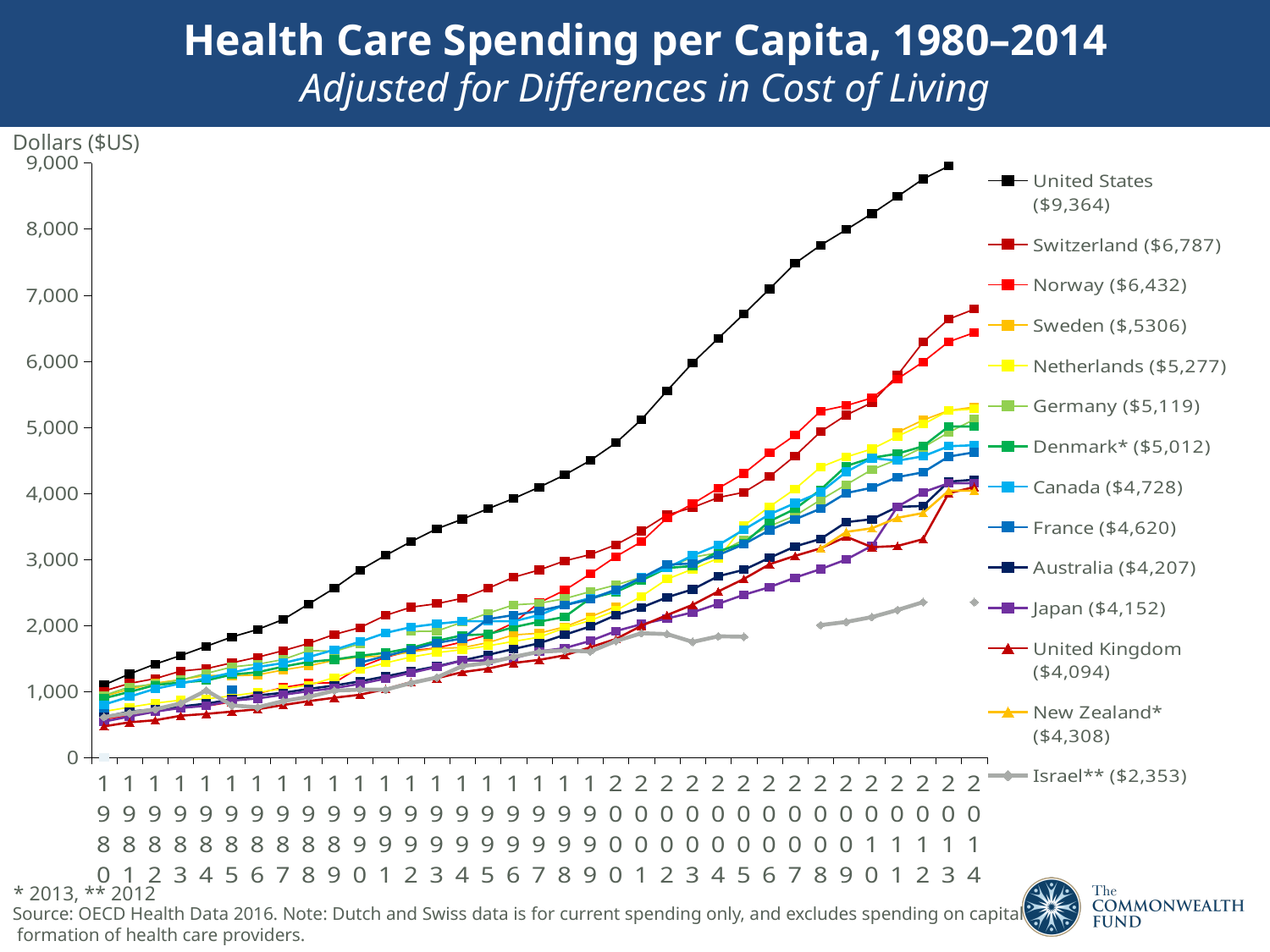
Is the value for Switzerland in 1980 greater or less than 2,000? less Which has the larger legend value, Norway or Switzerland? Switzerland Does the United States line rise or fall from 1980 to 2014? rise What is the label on the vertical axis? Dollars ($US) What value does the legend give for Canada? $4,728 Which country has the lowest health care spending per capita in the chart? Israel How many countries does the legend list? 14 What is the 2014 health care spending per capita for the United States shown in the legend? $9,364 Which country has the highest health care spending per capita in the chart? United States What kind of chart is shown on the slide? line chart What is the difference between the legend values for the United States and Switzerland? $2,577 Is the value for the United States in 2000 greater or less than 4,000? greater